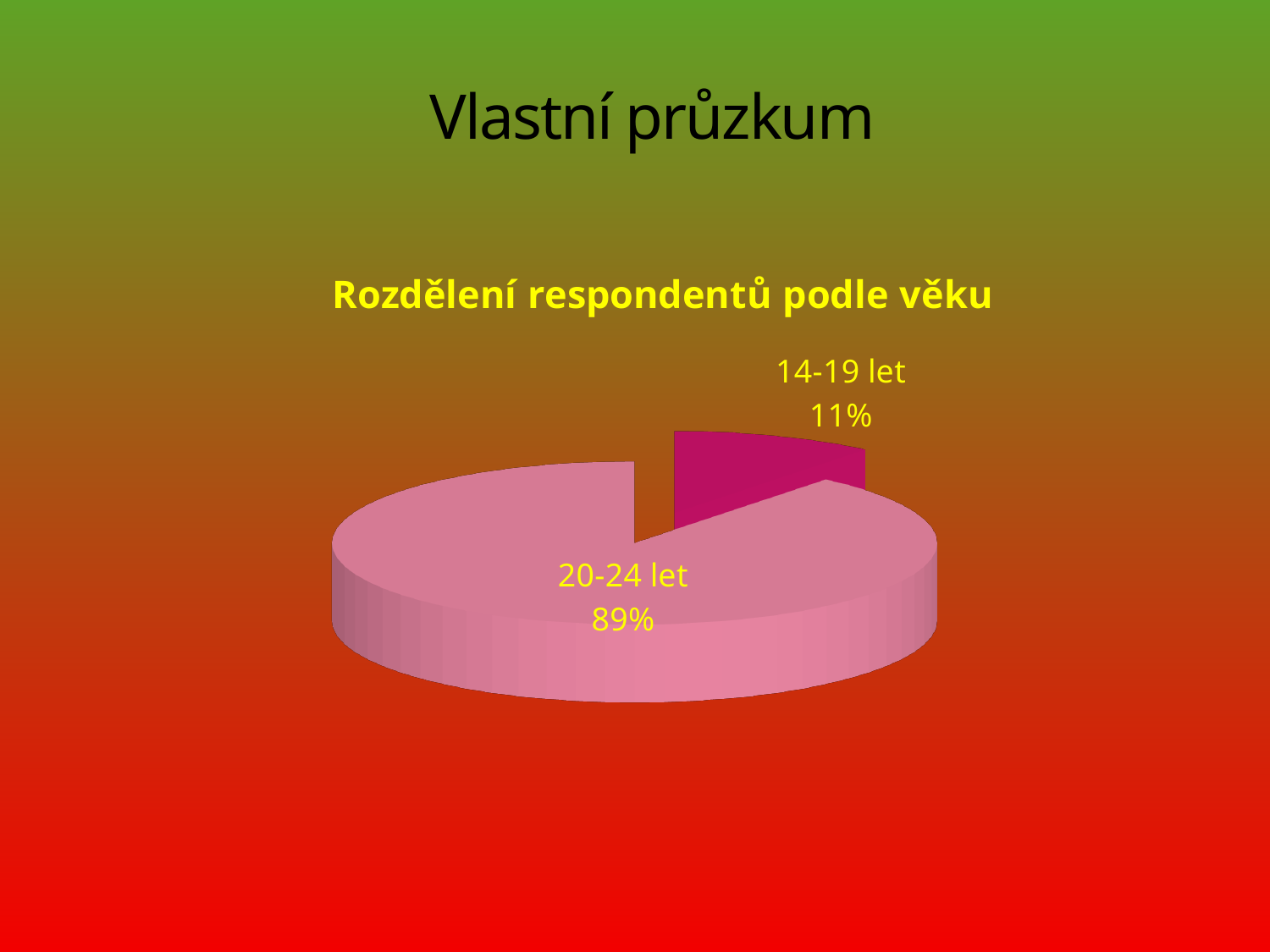
Which age group has the largest share of respondents? 20-24 let What is the difference in percentage points between the 20-24 let and 14-19 let shares? 78 What share of respondents are in the 14-19 let age group? 11% What share of respondents are in the 20-24 let age group? 89% What is the total of the two slice percentages shown? 100% Which age group has the smallest share of respondents? 14-19 let What kind of chart is shown on the slide? pie chart Which is larger: the share for 14-19 let or the share for 20-24 let? 20-24 let What is the title of the chart? Rozdělení respondentů podle věku How many age groups are shown in the pie chart? 2 What colour is the slice for 14-19 let? magenta